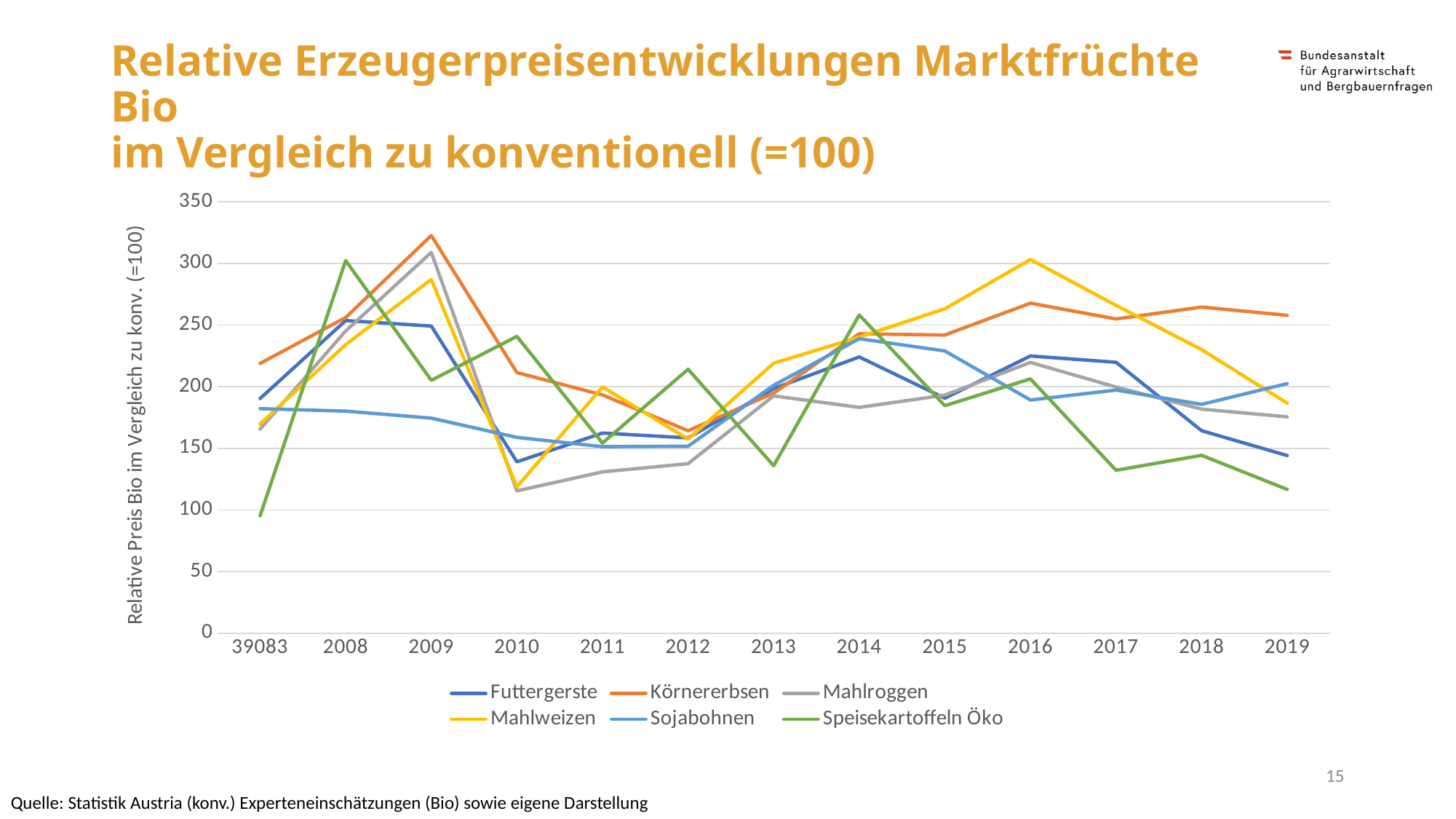
Is the value for Speisekartoffeln Öko in 2008 greater or less than 250? greater What is the label of the y axis? Relative Preis Bio im Vergleich zu konv. (=100) Which series has the highest value in 2016? Mahlweizen Is the value for Mahlroggen in 2010 greater or less than 150? less How many series does the legend list? 6 What kind of chart is shown on the slide? line chart How many points are shown along the x axis? 13 Is the value for Körnererbsen in 2009 greater or less than 300? greater Which series has the highest value in 2009? Körnererbsen Which series has the lowest value in 2019? Speisekartoffeln Öko In 2010, which is larger: the value for Körnererbsen or the value for Mahlweizen? Körnererbsen Does the value for Mahlweizen rise or fall from 2016 to 2019? fall